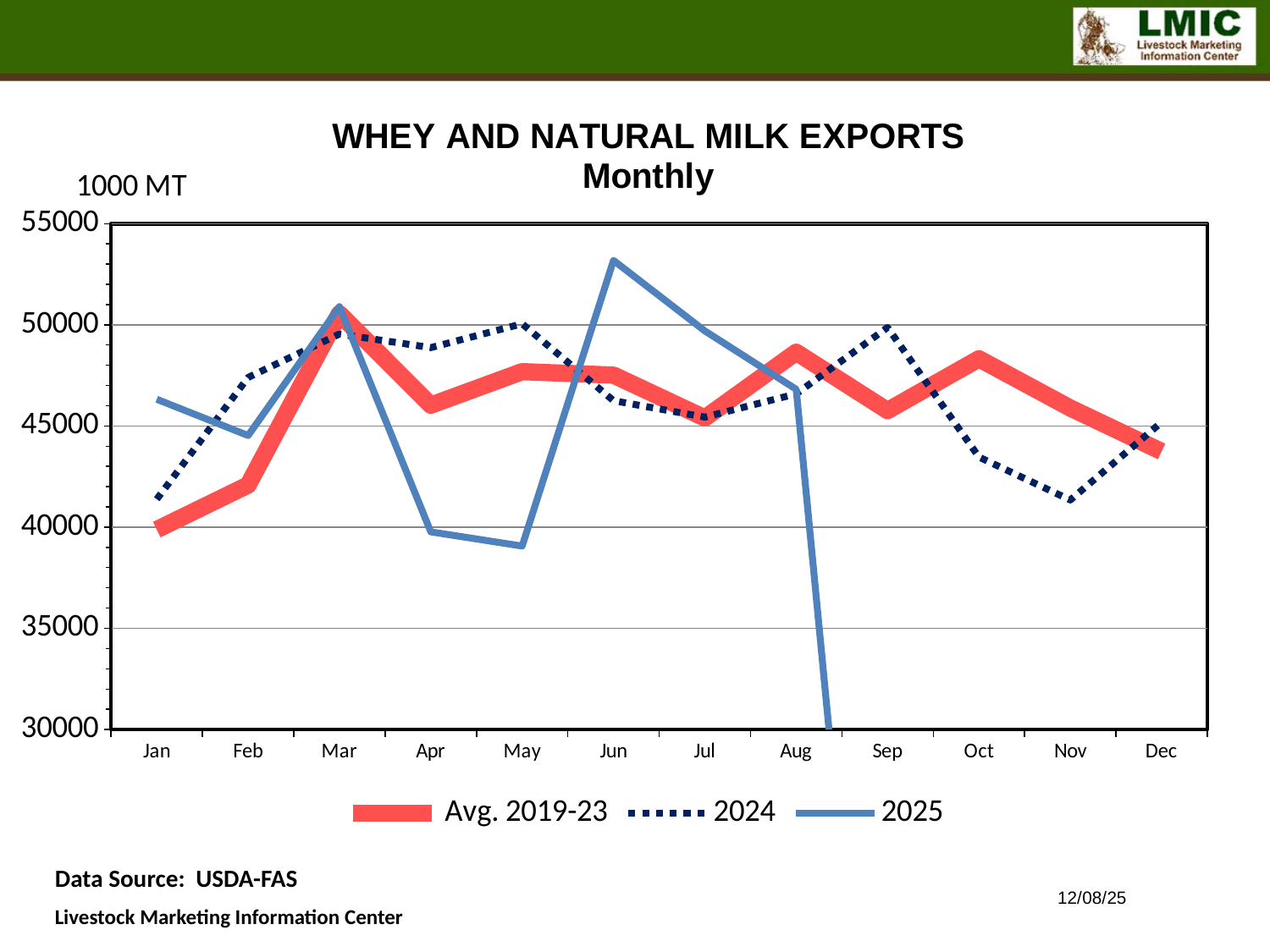
In Apr, which series has the larger value, 2024 or 2025? 2024 Which month has the highest value for the Avg. 2019-23 series? Mar Which month has the lowest value for the Avg. 2019-23 series? Jan Is the 2025 value for May greater or less than 40000? less How many months are shown along the x axis? 12 Which month has the highest value for the 2025 series? Jun What unit is shown on the y axis of the chart? 1000 MT Does the 2025 series rise or fall from Mar to Apr? Fall How many series does the legend list? 3 Is the 2025 value for Jun greater or less than 50000? greater What kind of chart is shown on the slide? Line chart Is the 2024 value for Jan greater or less than 40000? greater